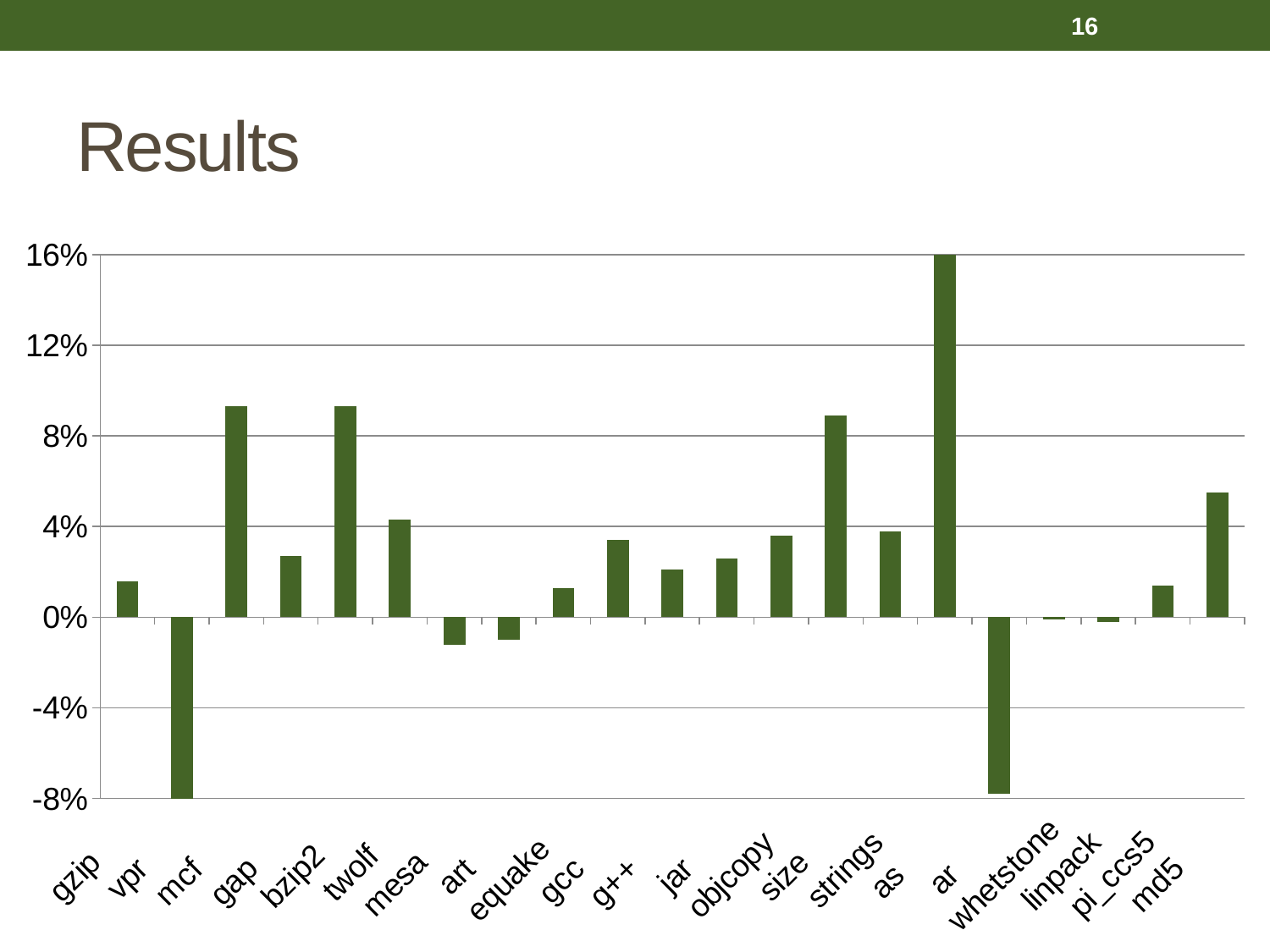
Which category has the highest value? as Is the value for ar greater or less than -4%? less Is the value for mcf greater or less than 8%? greater Which is larger, the value for objcopy or the value for g++? objcopy Which category has the lowest value? vpr Which is larger, the value for md5 or the value for twolf? md5 Is the value for gap greater or less than 4%? less What is the title of the slide containing the chart? Results What kind of chart is shown on the slide? bar chart How many categories are plotted along the x axis? 21 What is the value for as? 16%